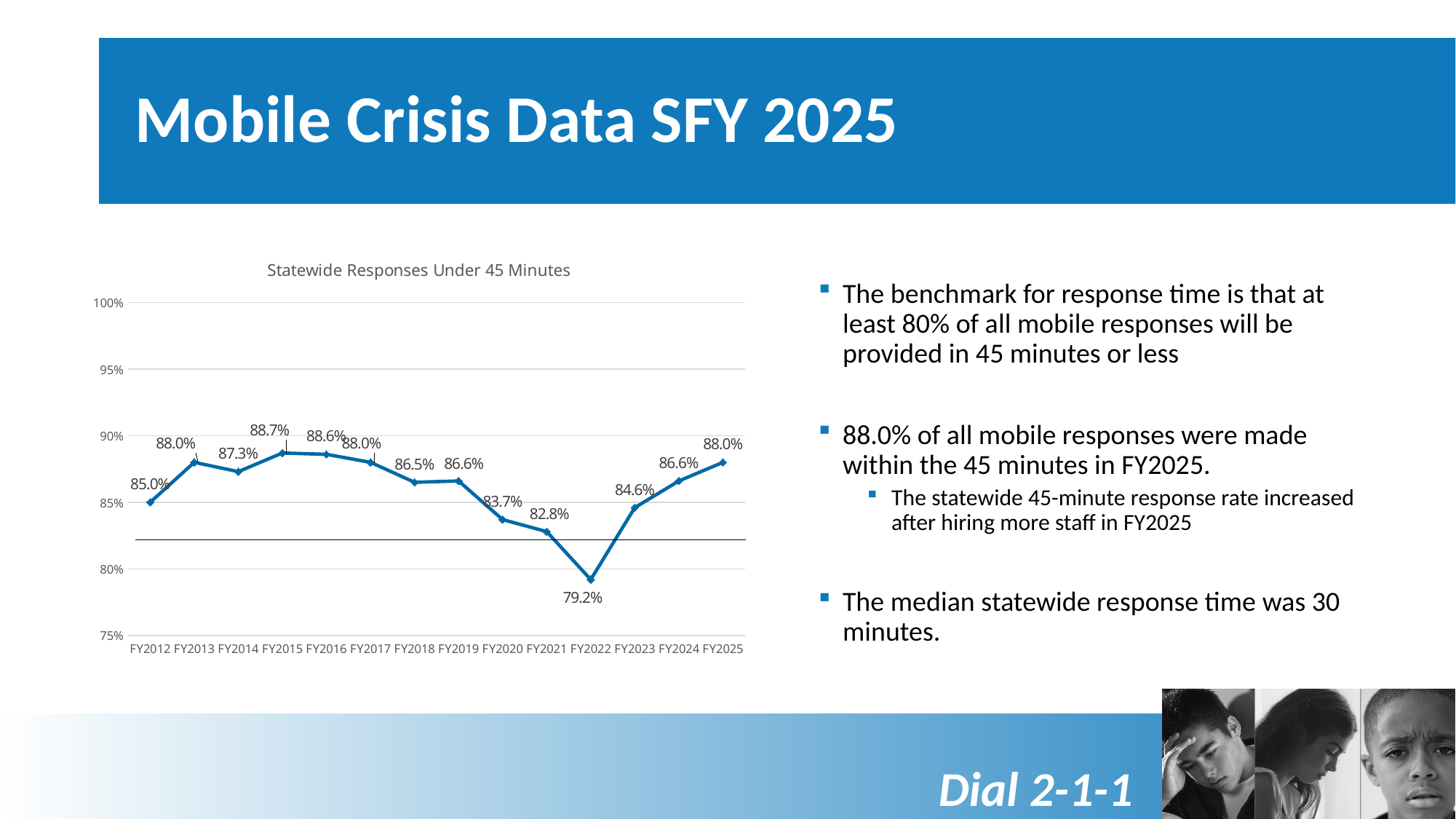
Which fiscal year has the lowest value in the Statewide Responses Under 45 Minutes chart? FY2022 What is the difference between the FY2025 value and the FY2022 value in the Statewide Responses Under 45 Minutes chart? 8.8 percentage points What is the value for FY2022 in the Statewide Responses Under 45 Minutes chart? 79.2% Do the values in the Statewide Responses Under 45 Minutes chart rise or fall from FY2022 to FY2025? rise What is the value for FY2025 in the Statewide Responses Under 45 Minutes chart? 88.0% What is the title of the chart on the slide? Statewide Responses Under 45 Minutes Is the value for FY2022 in the Statewide Responses Under 45 Minutes chart greater or less than 80%? less Which is larger in the Statewide Responses Under 45 Minutes chart, the value for FY2013 or the value for FY2014? FY2013 How many fiscal years are plotted in the Statewide Responses Under 45 Minutes chart? 14 What is the value for FY2012 in the Statewide Responses Under 45 Minutes chart? 85.0% Which fiscal year has the highest value in the Statewide Responses Under 45 Minutes chart? FY2015 What kind of chart is the Statewide Responses Under 45 Minutes chart? line chart